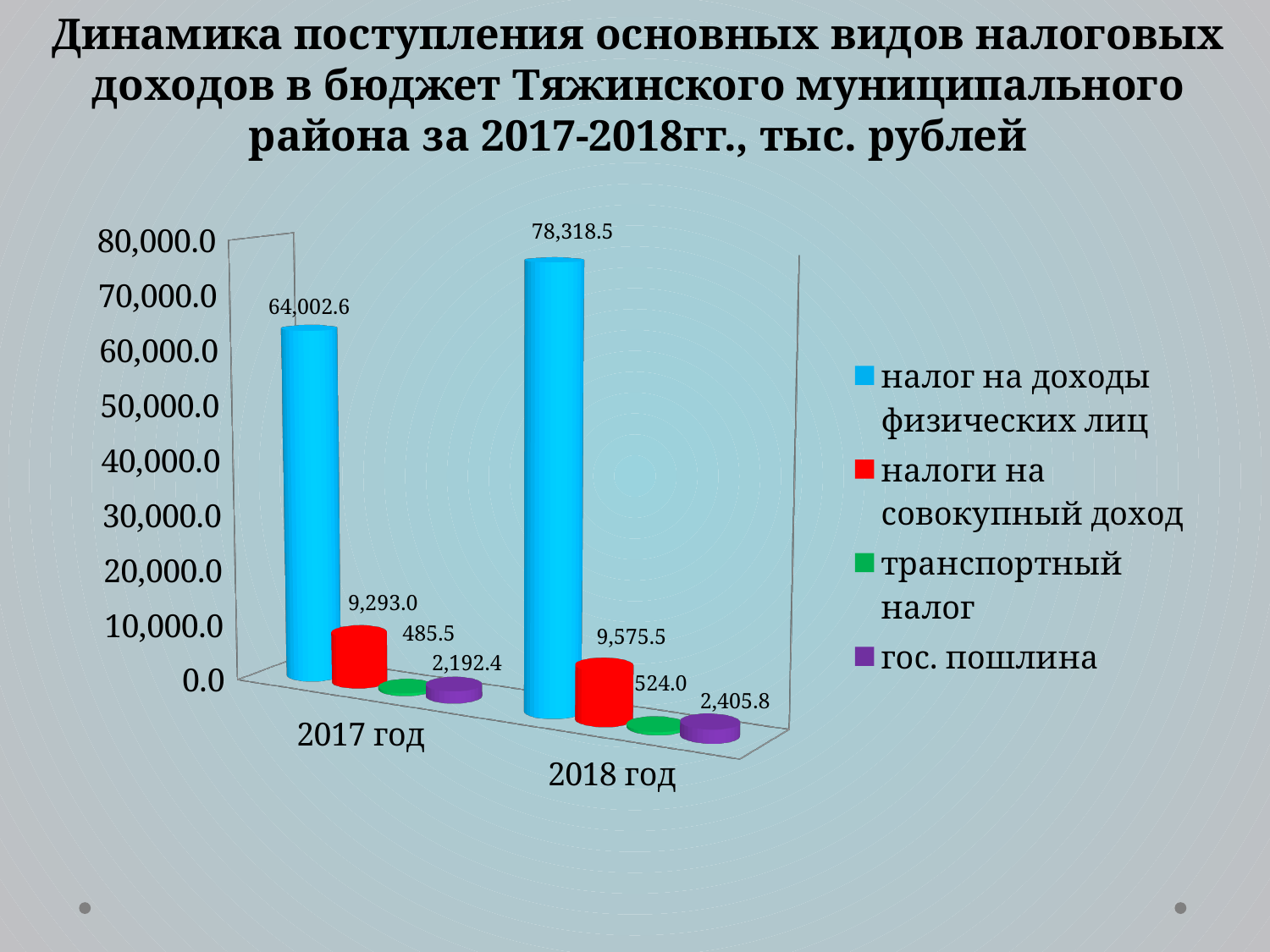
Which series has the highest value in 2017 год? налог на доходы физических лиц Which is larger: налоги на совокупный доход in 2017 год or in 2018 год? 2018 год What is the value for налог на доходы физических лиц in 2018 год? 78,318.5 What is the value for гос. пошлина in 2018 год? 2,405.8 What is the value for транспортный налог in 2017 год? 485.5 What is the value for налог на доходы физических лиц in 2017 год? 64,002.6 How many series does the legend list? 4 Which series has the lowest value in 2018 год? транспортный налог What is the difference between гос. пошлина in 2018 год and in 2017 год? 213.4 What is the value for налоги на совокупный доход in 2018 год? 9,575.5 What kind of chart is shown on the slide? bar chart By how much did налог на доходы физических лиц increase from 2017 год to 2018 год? 14,315.9